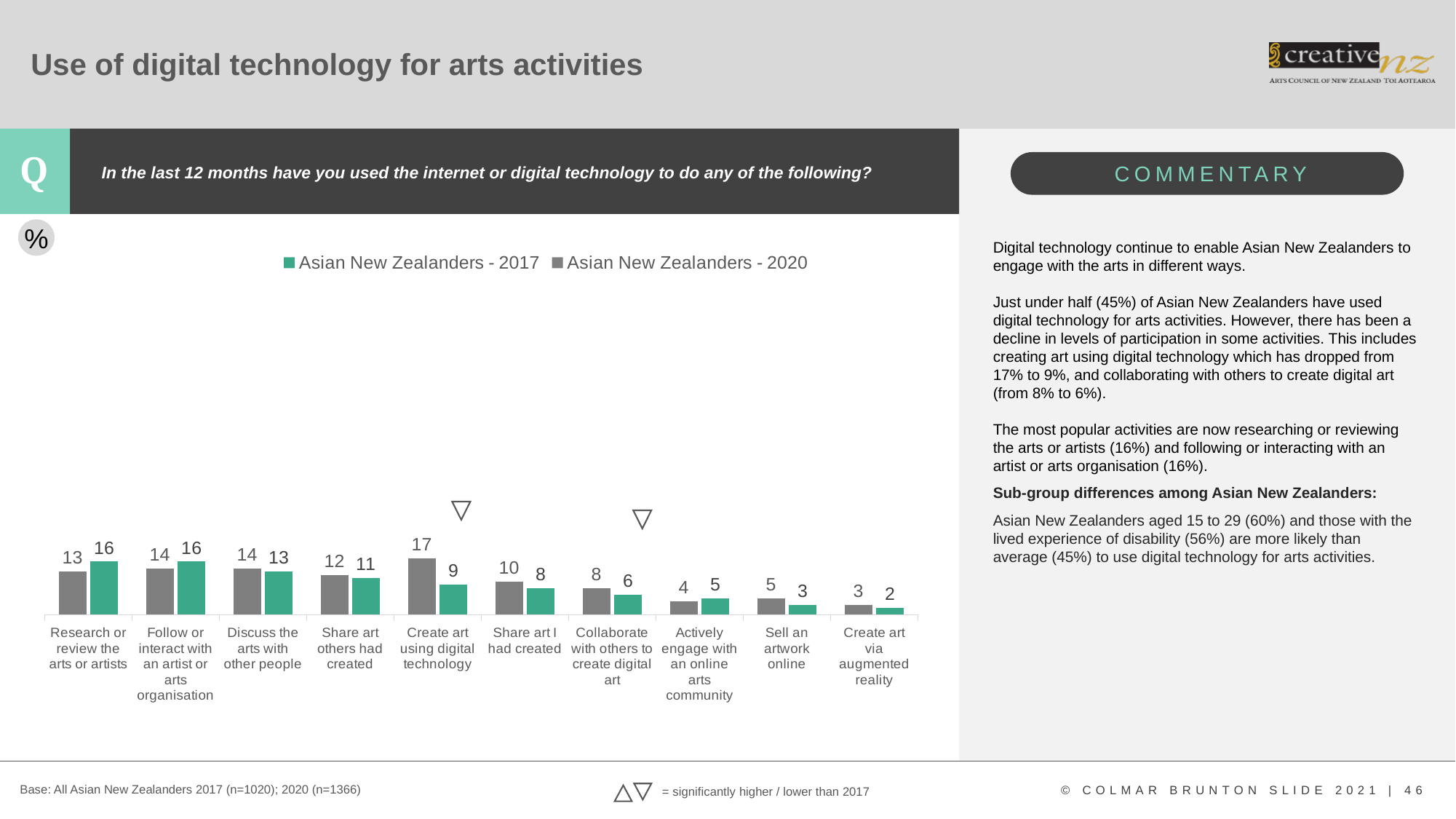
What is the value of the grey bar for 'Create art using digital technology'? 17 What are the two series names listed in the chart legend? Asian New Zealanders - 2017 and Asian New Zealanders - 2020 What kind of chart is shown on the slide? bar chart Which category has the highest value of any bar in the chart? Create art using digital technology Which category has the lowest value of any bar in the chart? Create art via augmented reality What is the difference between the grey bar and the green bar for 'Share art I had created'? 2 How many series does the chart legend list? 2 How many activity categories are shown along the x axis of the chart? 10 For 'Research or review the arts or artists', which bar is larger, the grey bar or the green bar? the green bar What is the value of the green bar for 'Create art using digital technology'? 9 What is the value of the grey bar for 'Sell an artwork online'? 5 What is the difference between the grey bar and the green bar for 'Create art using digital technology'? 8